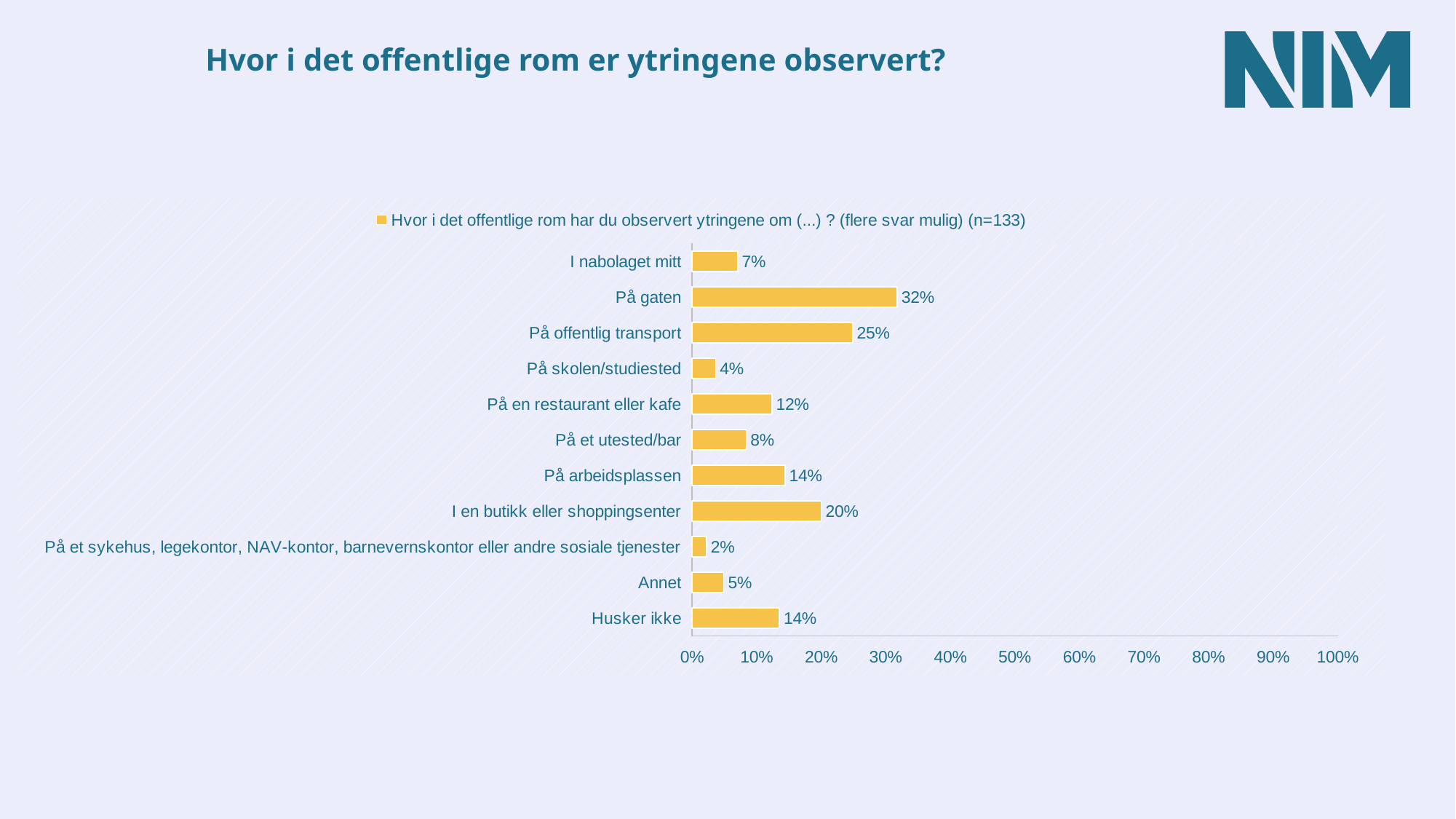
Which is larger, the value for "På en restaurant eller kafe" or the value for "På et utested/bar"? På en restaurant eller kafe How many categories are shown in the chart? 11 Is the value for "På gaten" greater or less than 30%? greater Which category has the lowest value? På et sykehus, legekontor, NAV-kontor, barnevernskontor eller andre sosiale tjenester What is the value for "I en butikk eller shoppingsenter"? 20% What kind of chart is shown on the slide? Bar chart What is the value for "Husker ikke"? 14% Which category has the highest value? På gaten What is the difference between the values for "På gaten" and "På offentlig transport"? 7% What is the title of the slide? Hvor i det offentlige rom er ytringene observert? What is the value for "På offentlig transport"? 25% What is the value for "På gaten"? 32%